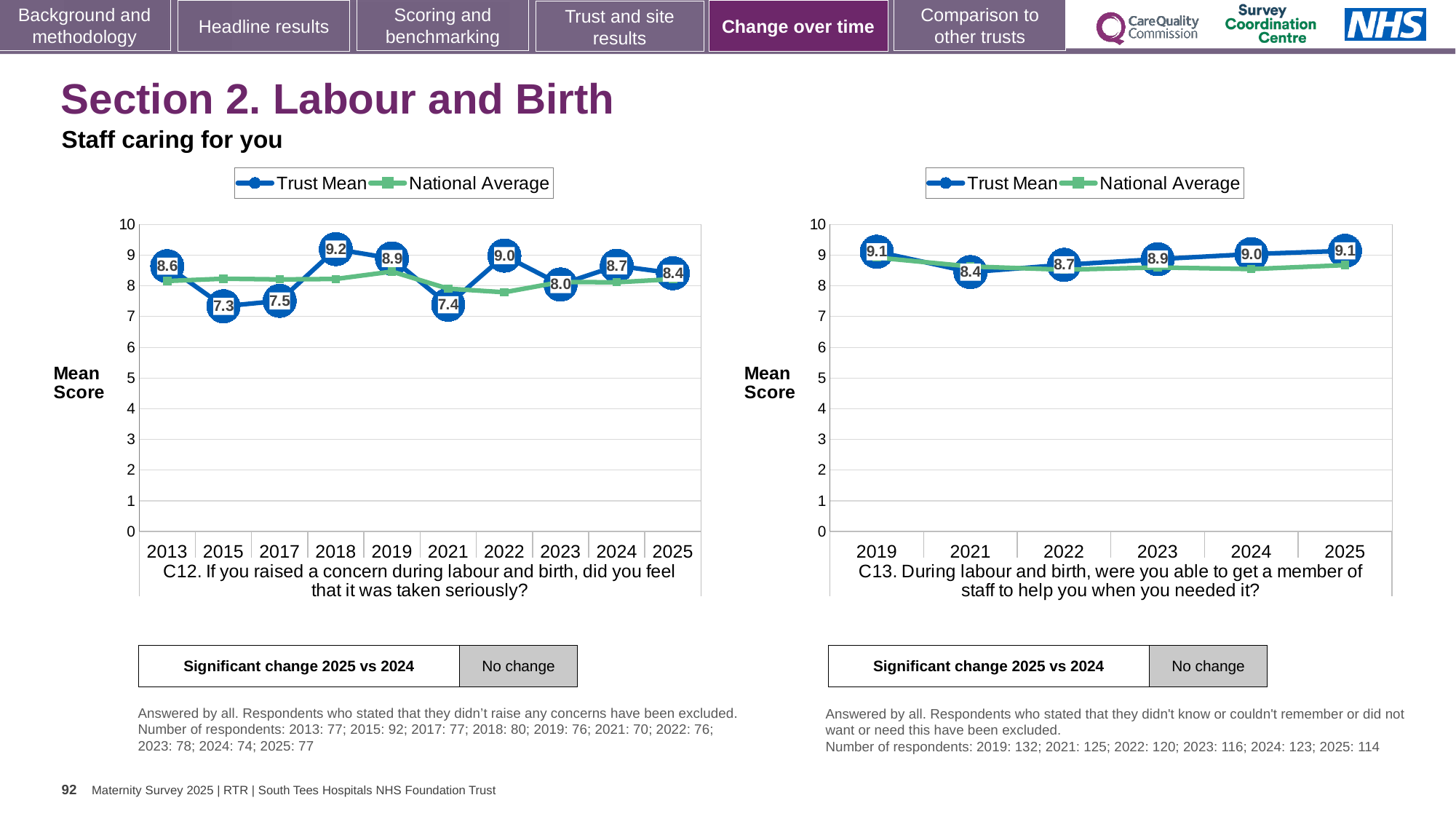
On the C12 chart (left), what is the Trust Mean score for 2025? 8.4 On the C12 chart (left), what is the difference between the Trust Mean scores for 2022 and 2023? 1.0 On the C12 chart (left), which year has the lowest Trust Mean score? 2015 On the C13 chart (right), what is the Trust Mean score for 2021? 8.4 On the C12 chart (left), how many years are shown on the x axis? 10 On the C13 chart (right), which year has the lowest Trust Mean score? 2021 On the C13 chart (right), is the National Average value for 2025 greater or less than 8? greater On the C13 chart (right), is the Trust Mean score for 2023 or 2024 larger? 2024 On the C12 chart (left), what is the Trust Mean score for 2018? 9.2 On the C13 chart (right), how many series does the legend list? 2 What kind of chart is the C13 chart (right)? Line chart On the C12 chart (left), which year has the highest Trust Mean score? 2018